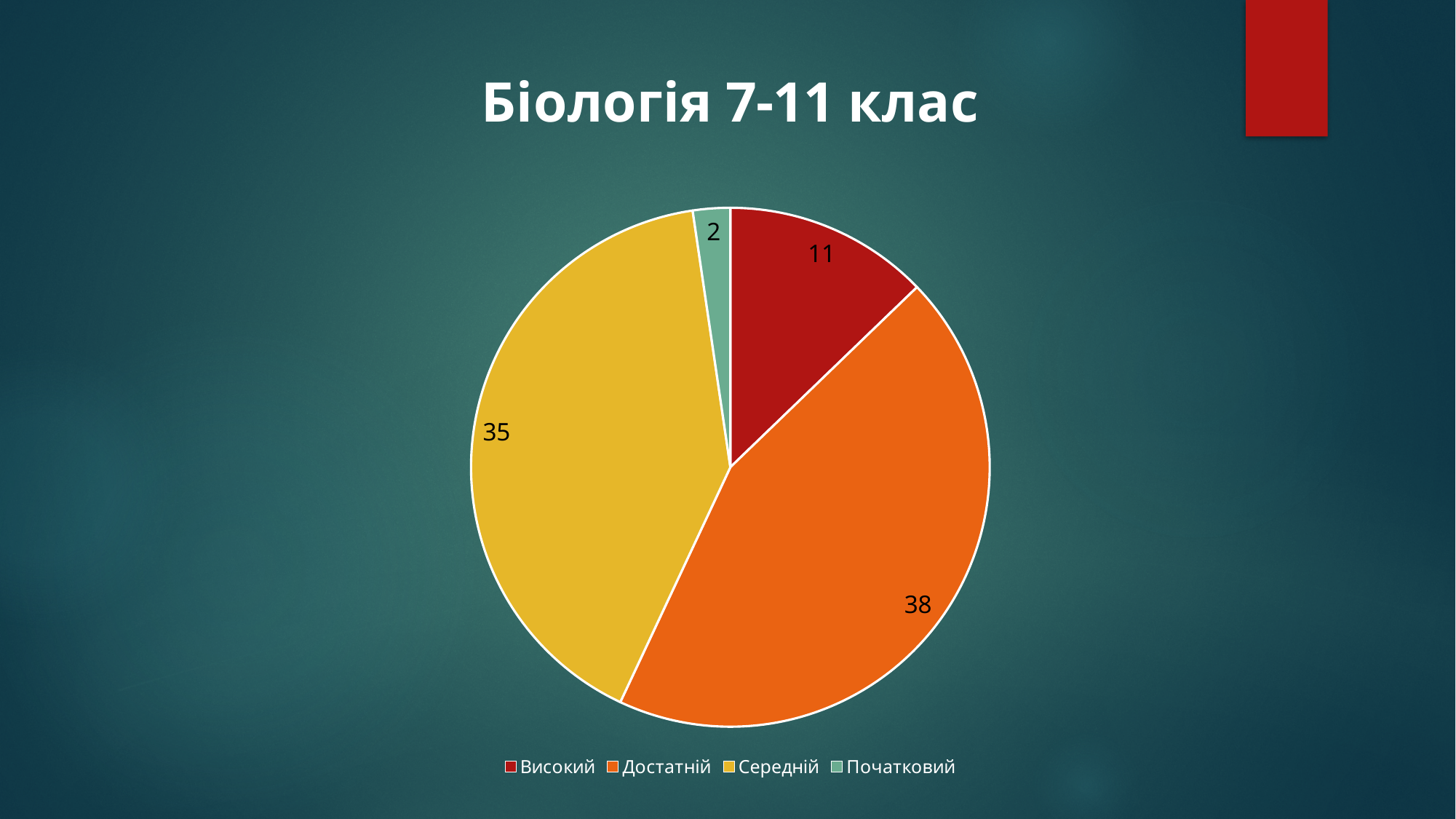
What type of chart is shown on the slide? pie chart What is the value for Достатній? 38 What is the value for Початковий? 2 How many categories does the pie chart have? 4 What is the difference between the values for Достатній and Середній? 3 What is the value for Високий? 11 What is the total of all the slices in the pie chart? 86 Which category has the smallest slice? Початковий Which category has the largest slice? Достатній What is the title of the chart? Біологія 7-11 клас What is the value for Середній? 35 Which is larger, the value for Високий or the value for Початковий? Високий